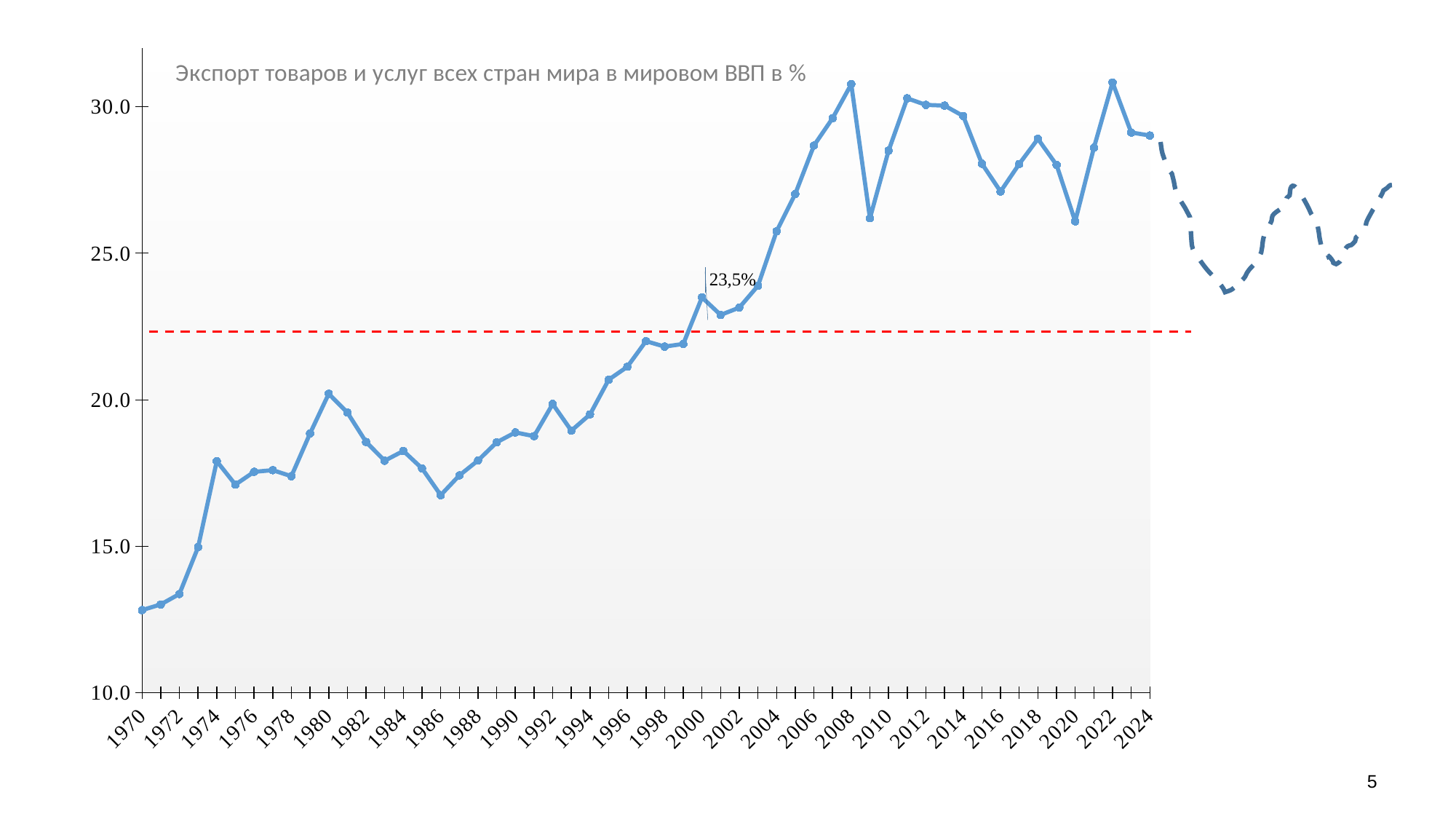
What is the title of the chart? Экспорт товаров и услуг всех стран мира в мировом ВВП в % Is the value for 1986 greater or less than 20.0? less Do the values generally rise or fall from 1970 to 2008? rise What kind of chart is shown on the slide? line chart Which year has the larger value, 2008 or 2009? 2008 Is the value for 1970 greater or less than 15.0? less Which year has the larger value, 1980 or 1986? 1980 Is the value for 2016 greater or less than 25.0? greater Which year has the lowest value on the chart? 1970 What value is printed as a data label on the chart near the year 2000? 23,5% What colour is the horizontal dashed reference line on the chart? red